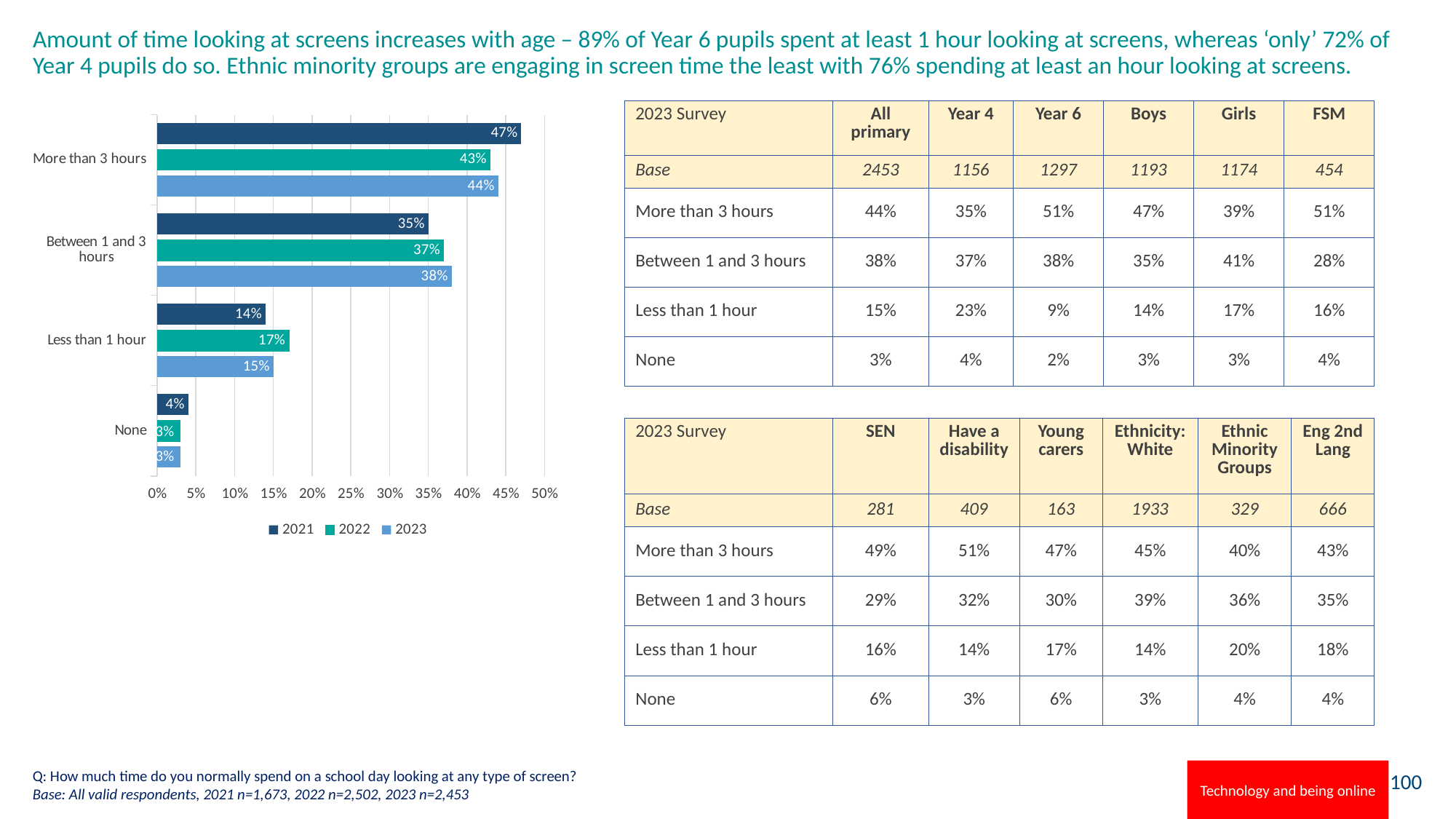
Which category has the highest value for the 2023 series? More than 3 hours How many series does the chart's legend list? 3 What is the 2021 value for 'More than 3 hours'? 47% Which is larger for 'Less than 1 hour': the 2021 value or the 2022 value? 2022 What is the difference between the 2021 and 2022 values for 'More than 3 hours'? 4% Which category has the lowest value for the 2022 series? None What is the 2022 value for 'Less than 1 hour'? 17% What is the 2023 value for 'Between 1 and 3 hours'? 38% How many categories are shown on the chart? 4 What kind of chart is shown on the slide? bar chart What is the 2021 value for 'None'? 4% Which series is shown in the darkest blue colour in the legend? 2021